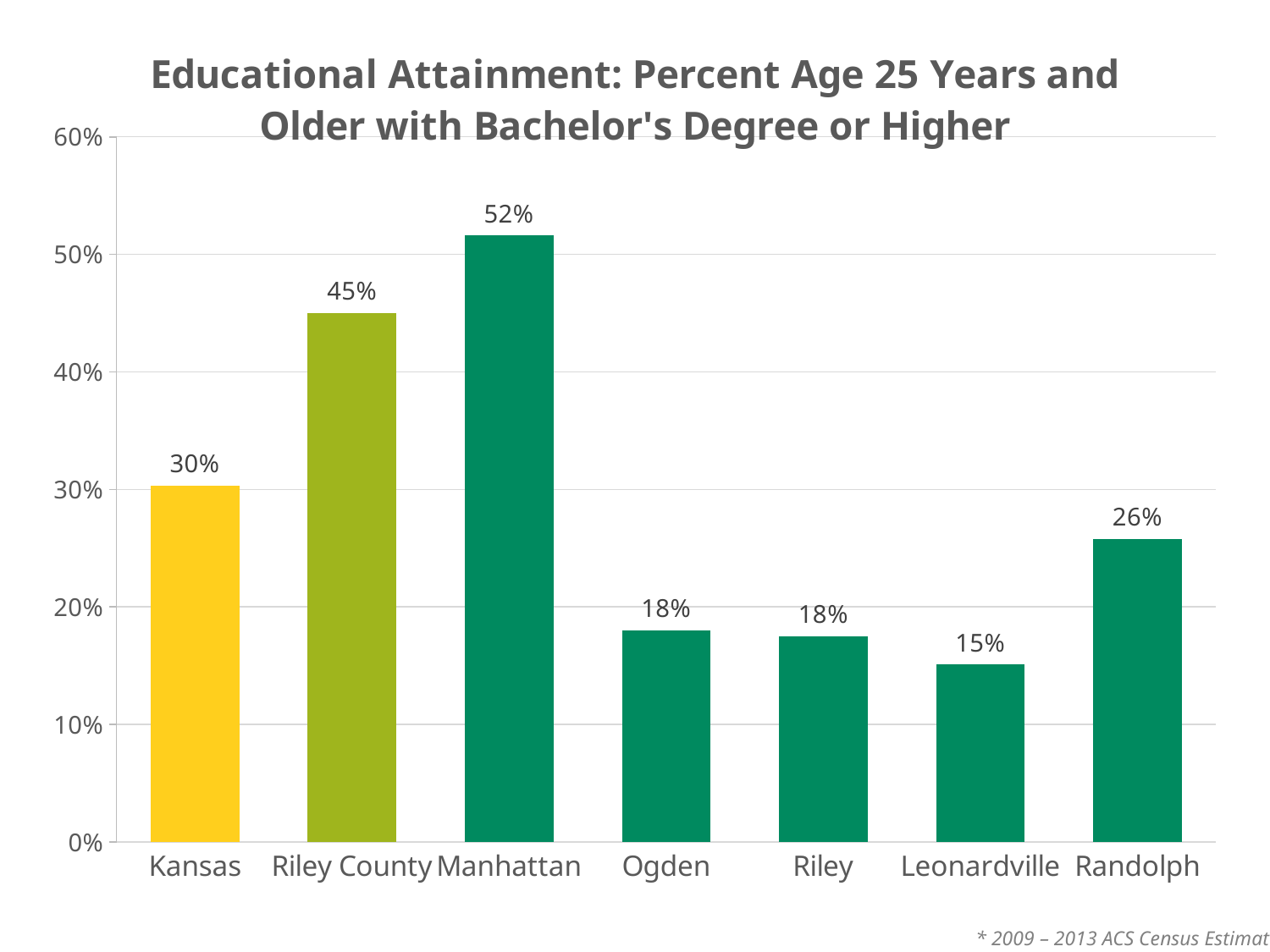
What is the value for Kansas? 30% What is the value for Randolph? 26% What colour is the bar for Kansas? yellow Which is larger, the value for Kansas or the value for Randolph? Kansas Which category has the highest value? Manhattan Which category has the lowest value? Leonardville What kind of chart is shown on the slide? bar chart What is the value for Manhattan? 52% What is the value for Leonardville? 15% What is the difference between the values for Manhattan and Riley County? 7% Is the value for Riley County greater or less than 40%? greater How many categories are shown on the x axis? 7